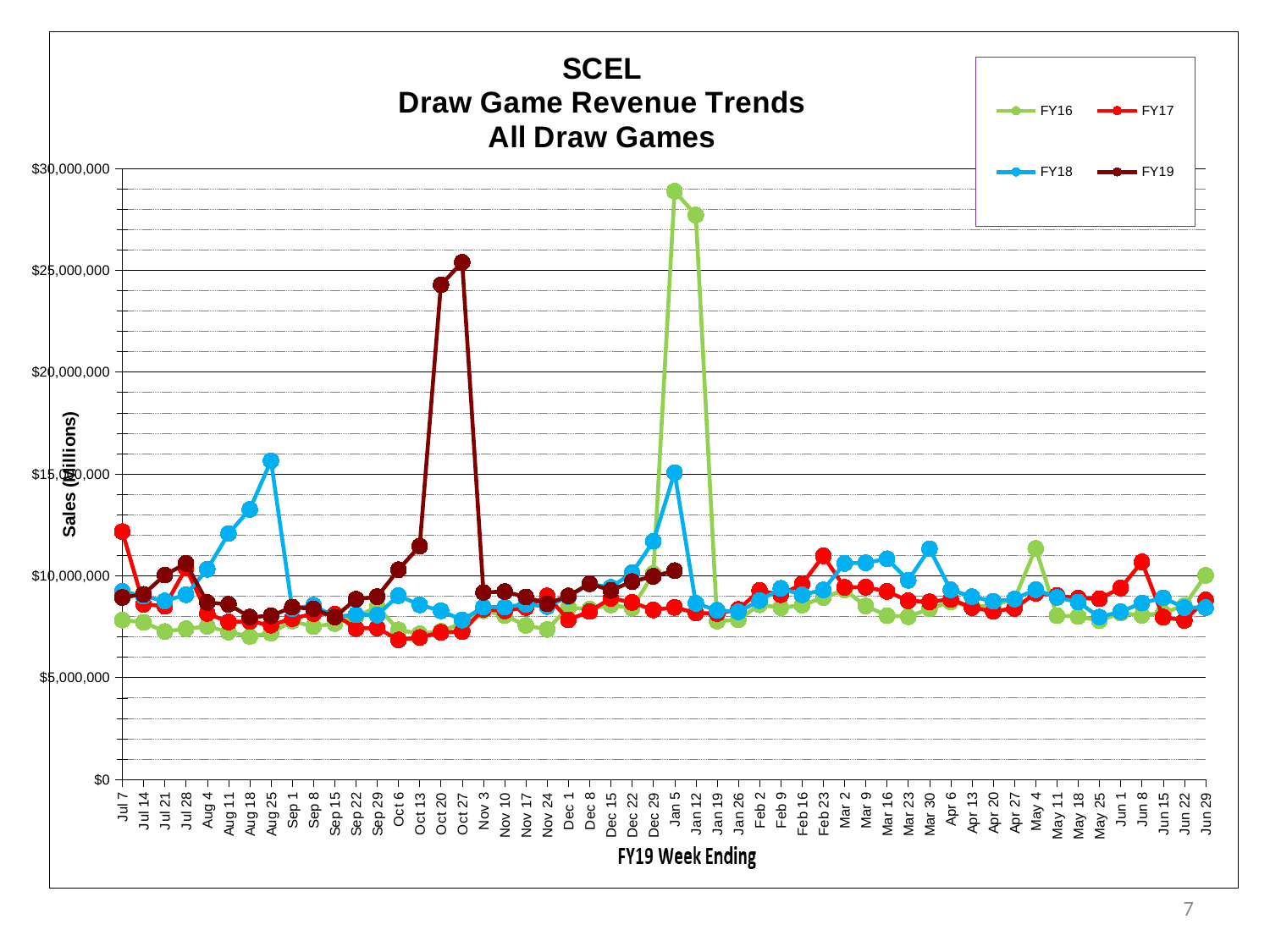
Which series reaches the highest value on the chart? FY16 Which is larger: the FY16 peak at Jan 5 or the FY19 peak at Oct 27? FY16 peak at Jan 5 Is the FY19 value for Oct 20 greater or less than $20,000,000? greater What kind of chart is shown on the slide? Line chart Is the FY19 value for Nov 3 greater or less than $15,000,000? less Which series are listed in the legend? FY16, FY17, FY18, FY19 What is the title of the x axis? FY19 Week Ending Which series has its largest spike in late October (Oct 20 and Oct 27)? FY19 Is the FY17 value for Jul 7 greater or less than $10,000,000? greater How many series does the legend list? 4